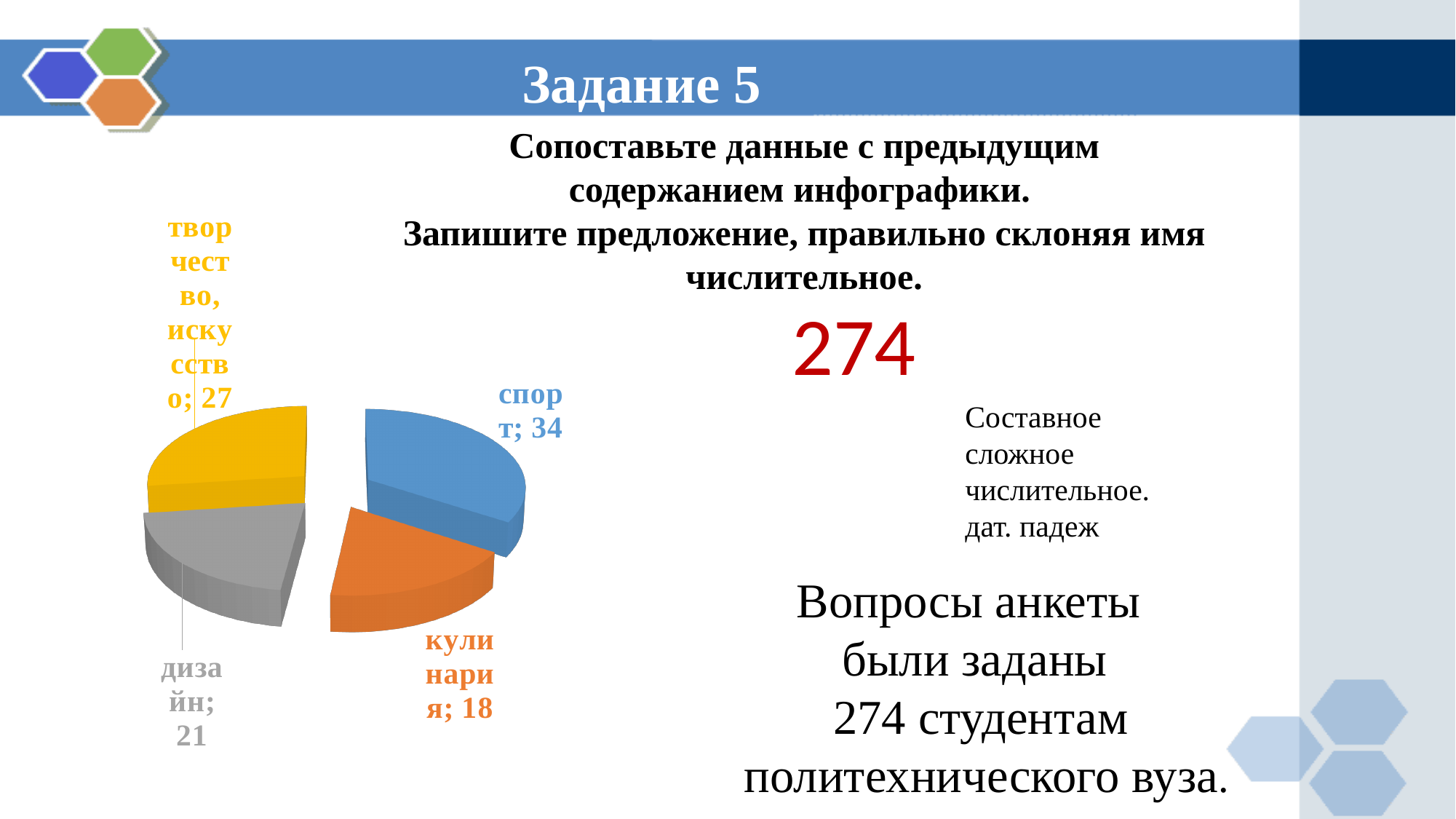
Which category has the largest slice in the pie chart? спорт What colour is the slice for кулинария? orange What kind of chart is shown on the slide? pie chart What share of the pie does спорт represent? 34% Which is larger, the value for дизайн or the value for творчество, искусство? творчество, искусство What is the value for спорт in the pie chart? 34 How many slices does the pie chart have? 4 What is the value for дизайн in the pie chart? 21 What is the difference between the values for спорт and кулинария? 16 Which category has the smallest slice in the pie chart? кулинария What is the value for кулинария in the pie chart? 18 What is the value for творчество, искусство in the pie chart? 27